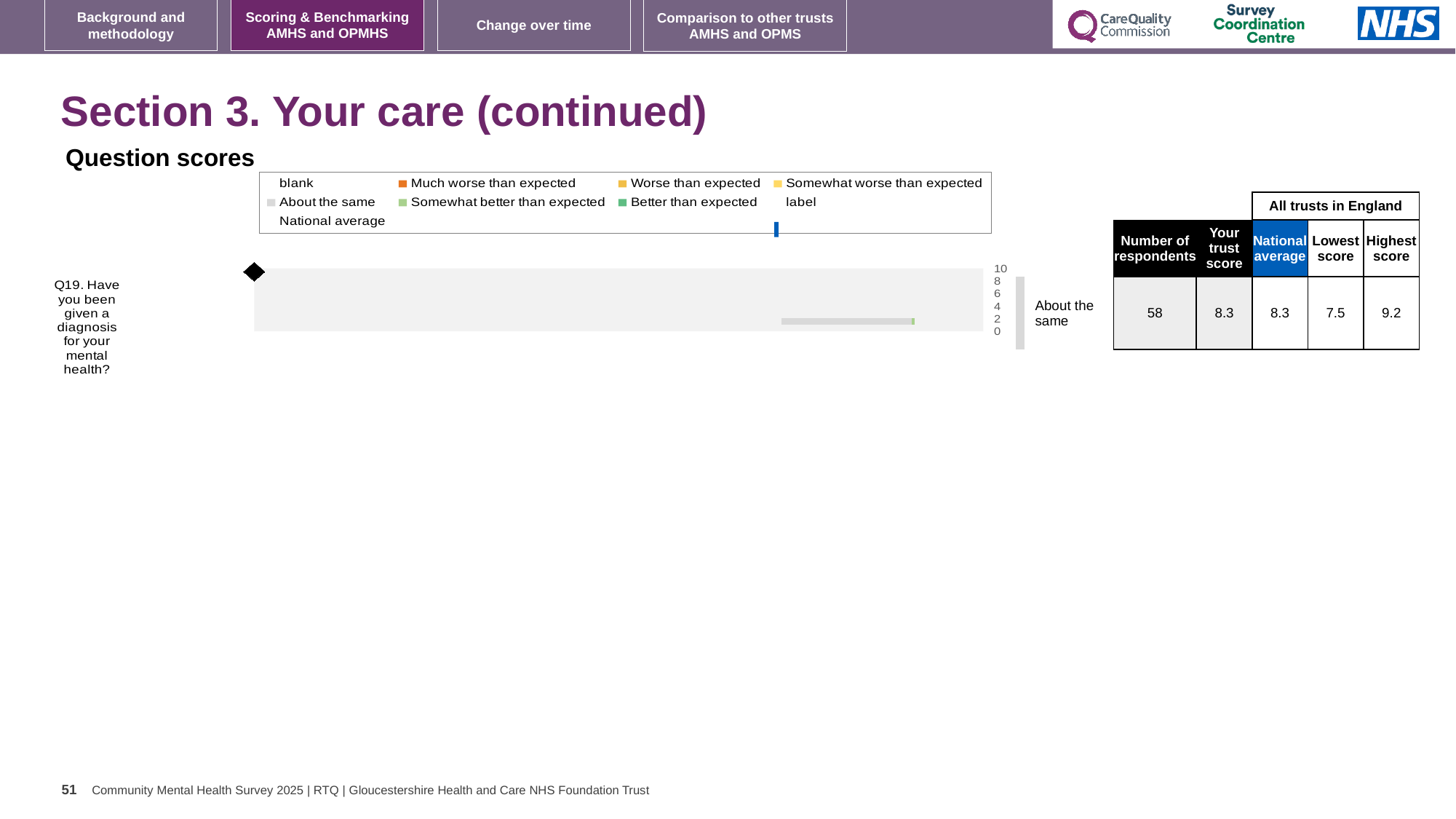
Is the trust score for Q19 higher than, lower than, or the same as the national average? The same Which question is plotted in the Question scores chart? Q19. Have you been given a diagnosis for your mental health? What kind of chart is used to show the question scores on this slide? Bar chart What is the highest score among all trusts in England for Q19? 9.2 What is the lowest score among all trusts in England for Q19? 7.5 What is the maximum value shown on the score axis of the Question scores chart? 10 What benchmark category is shown next to the bar for Q19? About the same What is the difference between the highest score and the lowest score for Q19? 1.7 What is the national average score for Q19? 8.3 How many survey questions are plotted in the Question scores chart? 1 What is the trust score for Q19? 8.3 How many respondents answered Q19? 58